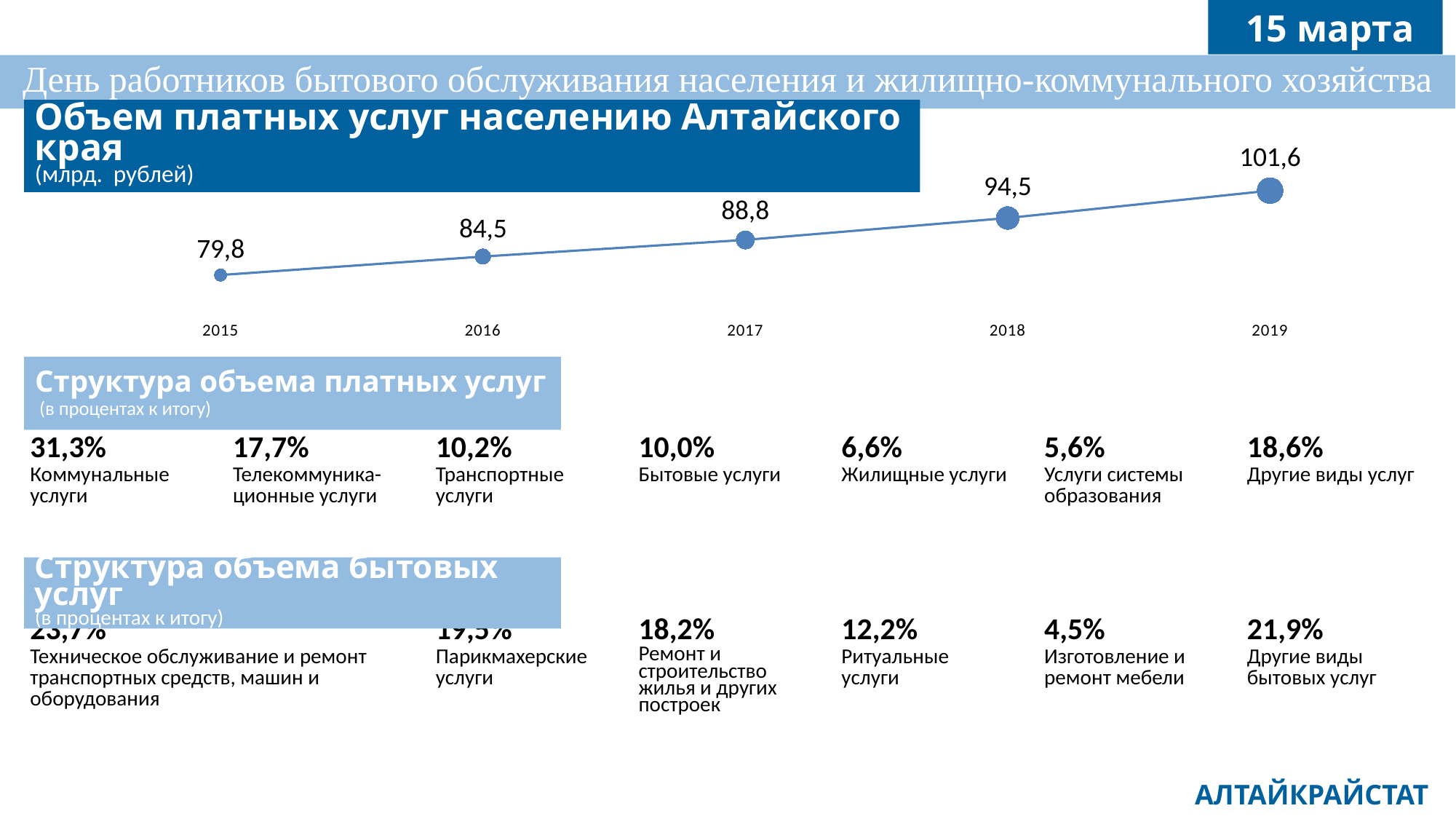
What is the value for 2019 in the chart 'Объем платных услуг населению Алтайского края'? 101,6 What is the value for 2015 in the chart 'Объем платных услуг населению Алтайского края'? 79,8 Do the values in the chart 'Объем платных услуг населению Алтайского края' rise or fall from 2015 to 2019? rise What kind of chart is 'Объем платных услуг населению Алтайского края'? line chart Which year has the highest value in the chart 'Объем платных услуг населению Алтайского края'? 2019 Which year has the lowest value in the chart 'Объем платных услуг населению Алтайского края'? 2015 How many years are plotted in the chart 'Объем платных услуг населению Алтайского края'? 5 What is the value for 2017 in the chart 'Объем платных услуг населению Алтайского края'? 88,8 In the chart 'Объем платных услуг населению Алтайского края', what is the difference between the values for 2019 and 2015? 21,8 In the chart 'Объем платных услуг населению Алтайского края', what is the difference between the values for 2018 and 2017? 5,7 In what units are the values of the chart 'Объем платных услуг населению Алтайского края' given? млрд. рублей In the chart 'Объем платных услуг населению Алтайского края', which year has the larger value, 2016 or 2018? 2018